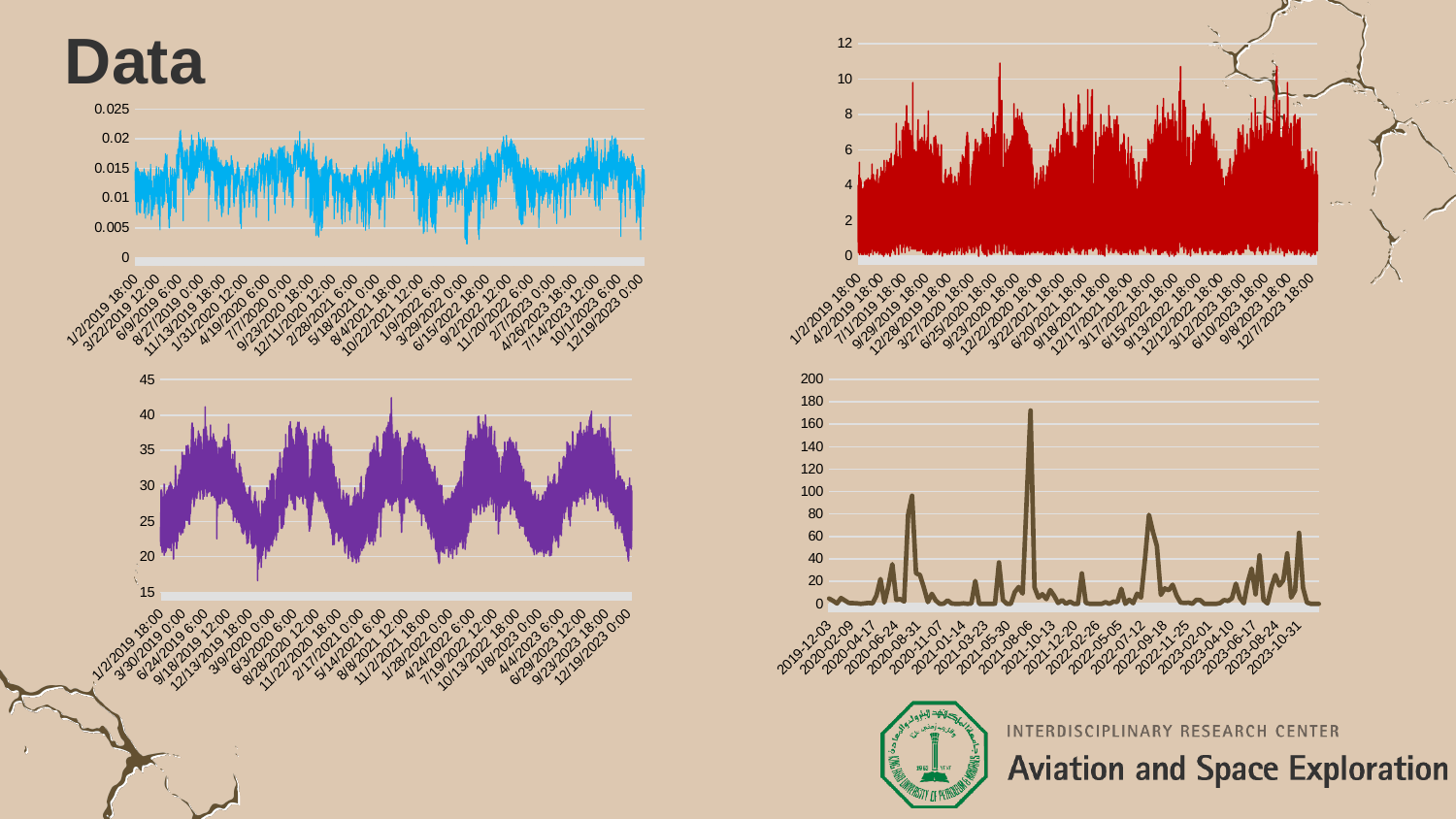
How many charts are shown on the slide? 4 In the bottom-left chart, is the highest value greater or less than 45? less In the bottom-right chart, is the highest peak (near 2021-08-06) greater or less than 160? greater What kind of chart is the top-left chart on the slide? line chart In the bottom-left chart, is the lowest value greater or less than 15? greater What colour is the line in the top-right chart? red What kind of chart is the bottom-right chart on the slide? line chart What is the first x-axis label on the bottom-right chart? 2019-12-03